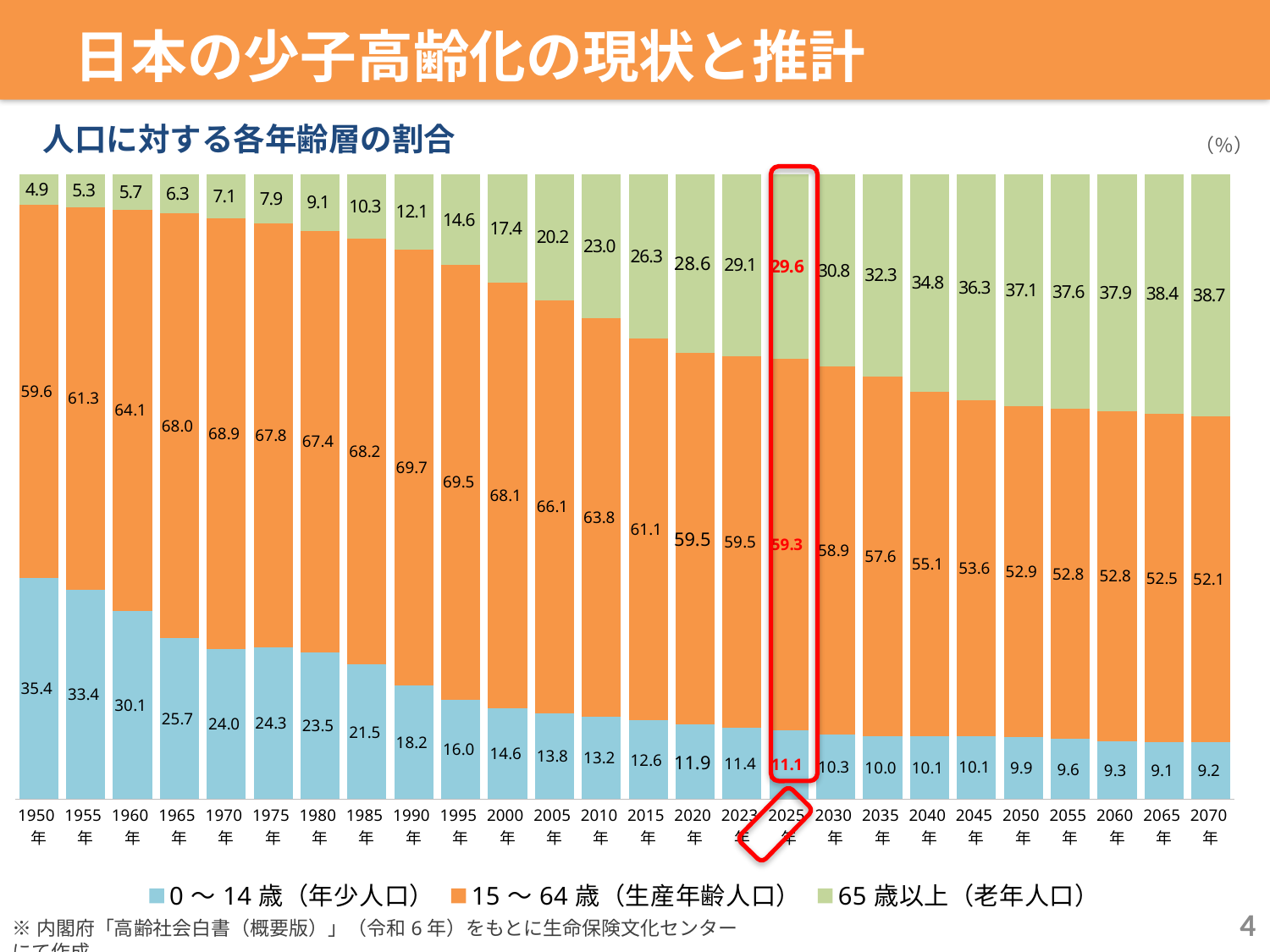
How many years (bars) are shown on the x axis? 26 What is the value for 0～14歳（年少人口） in 1950年? 35.4 What is the title of the chart? 人口に対する各年齢層の割合 Which is larger in 2023年: the 0～14歳（年少人口） share or the 65歳以上（老年人口） share? 65歳以上（老年人口） What is the value for 65歳以上（老年人口） in 2025年? 29.6 In which year is the 15～64歳（生産年齢人口） share highest? 1990年 How does the 0～14歳（年少人口） share change from 1950年 to 2070年? It falls How many series does the legend list? 3 What is the value for 15～64歳（生産年齢人口） in 2070年? 52.1 What is the difference between the 65歳以上（老年人口） share in 2070年 and in 1950年? 33.8 What type of chart is shown on the slide? stacked bar chart In which year is the 65歳以上（老年人口） share lowest? 1950年